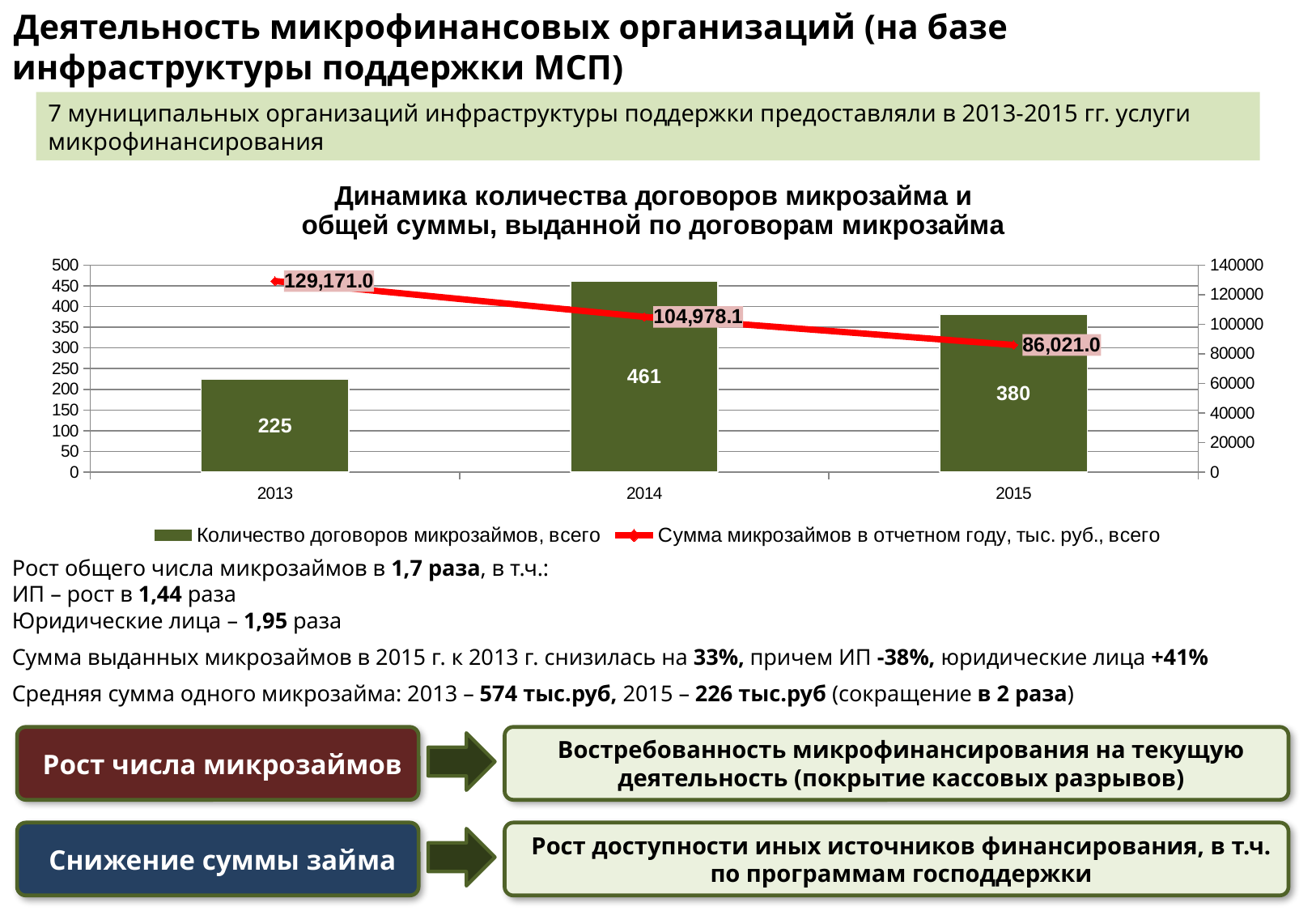
Which year has the highest number of microloan contracts? 2014 What is the difference between the number of microloan contracts in 2014 and in 2013? 236 What is the value of the line series (Сумма микрозаймов в отчетном году, тыс. руб., всего) for 2013? 129,171.0 What is the value of the line series (Сумма микрозаймов в отчетном году, тыс. руб., всего) for 2015? 86,021.0 Is the number of microloan contracts larger in 2015 or in 2013? 2015 Which year has the lowest value for the sum of microloans (line series)? 2015 How many series does the chart legend list? 2 Which year has the lowest number of microloan contracts? 2013 What colour are the bars in the chart? dark green What is the number of microloan contracts (Количество договоров микрозаймов, всего) in 2014? 461 How many years are shown on the x axis of the chart? 3 Does the sum of microloans (line series) rise or fall from 2013 to 2015? fall